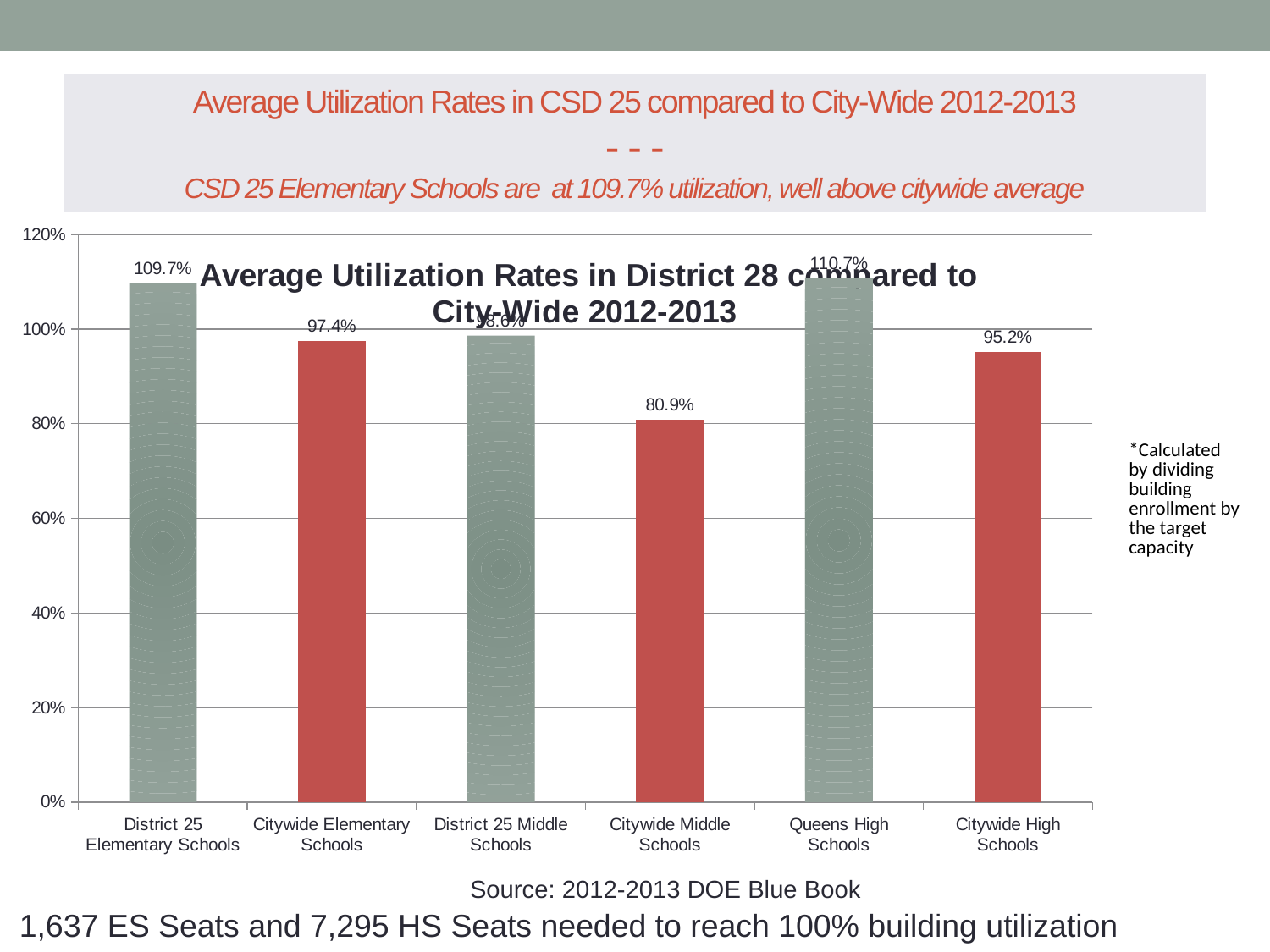
What is the average utilization rate for Citywide High Schools? 95.2% What is the title printed inside the chart area? Average Utilization Rates in District 28 compared to City-Wide 2012-2013 What is the difference in utilization rate between District 25 Elementary Schools and Citywide Elementary Schools? 12.3 percentage points What is the average utilization rate for Citywide Elementary Schools? 97.4% How many categories are shown on the x axis of the chart? 6 Is the utilization rate for Citywide Middle Schools greater or less than 100%? less What type of chart is shown on the slide? Bar chart Which has a higher utilization rate, District 25 Elementary Schools or Citywide Elementary Schools? District 25 Elementary Schools What is the difference in utilization rate between Citywide High Schools and Citywide Middle Schools? 14.3 percentage points What is the average utilization rate for District 25 Elementary Schools? 109.7% Which category has the lowest utilization rate? Citywide Middle Schools What is the average utilization rate for Citywide Middle Schools? 80.9%